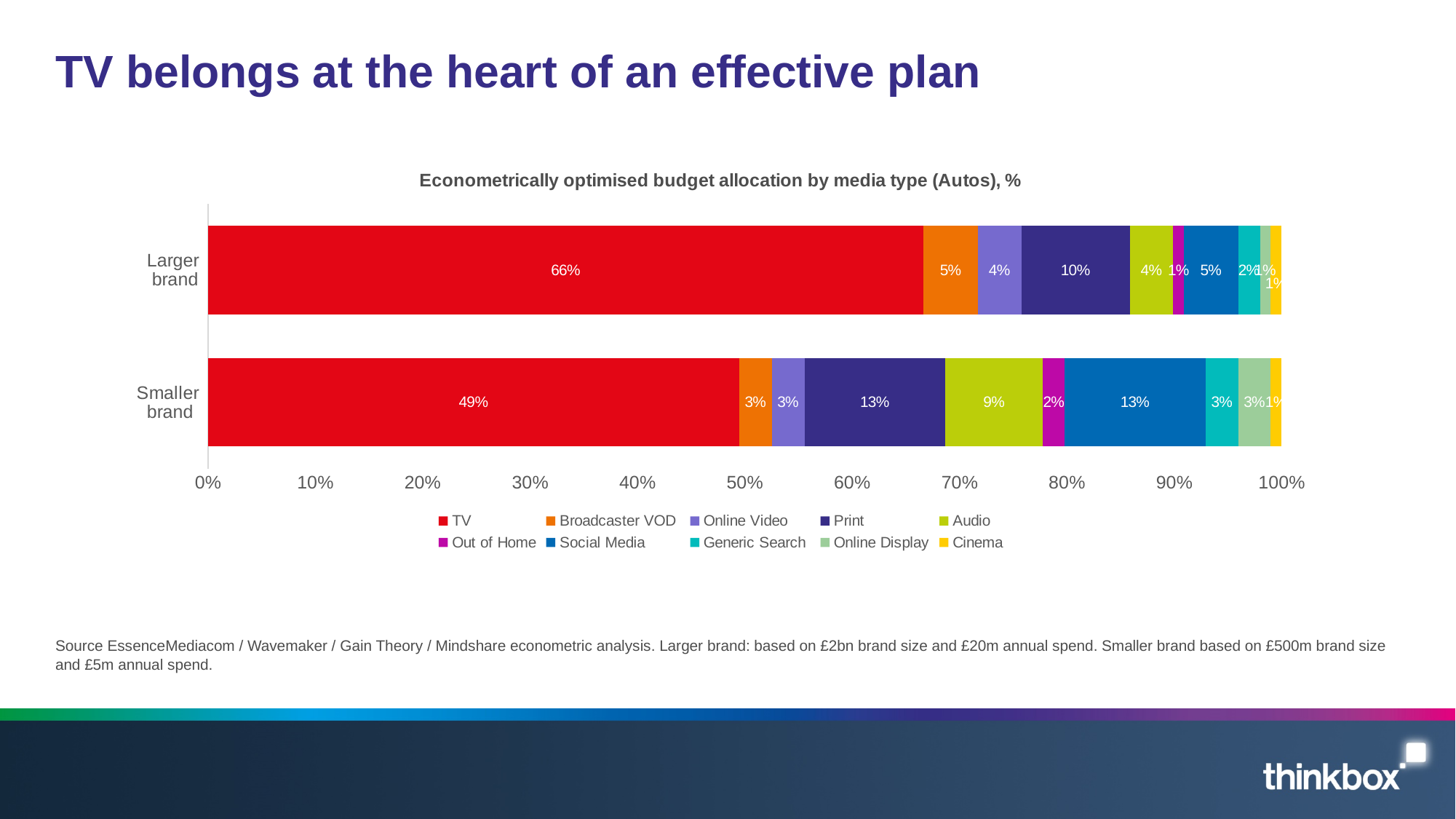
Which brand has the larger Print allocation, the Larger brand or the Smaller brand? Smaller brand How many brand categories are shown on the chart? 2 How many percentage points higher is the TV allocation for the Larger brand than for the Smaller brand? 17 percentage points What percentage of the Smaller brand's budget is allocated to Social Media? 13% What percentage of the Smaller brand's budget is allocated to Print? 13% Which media type receives the largest share of the Larger brand's budget? TV What type of chart is shown on the slide? Stacked bar chart What percentage of the Smaller brand's budget is allocated to Audio? 9% What is the TV share of the optimised budget allocation for the Smaller brand? 49% How many media types does the legend list? 10 What is the TV share of the optimised budget allocation for the Larger brand? 66% What percentage of the Larger brand's budget is allocated to Print? 10%